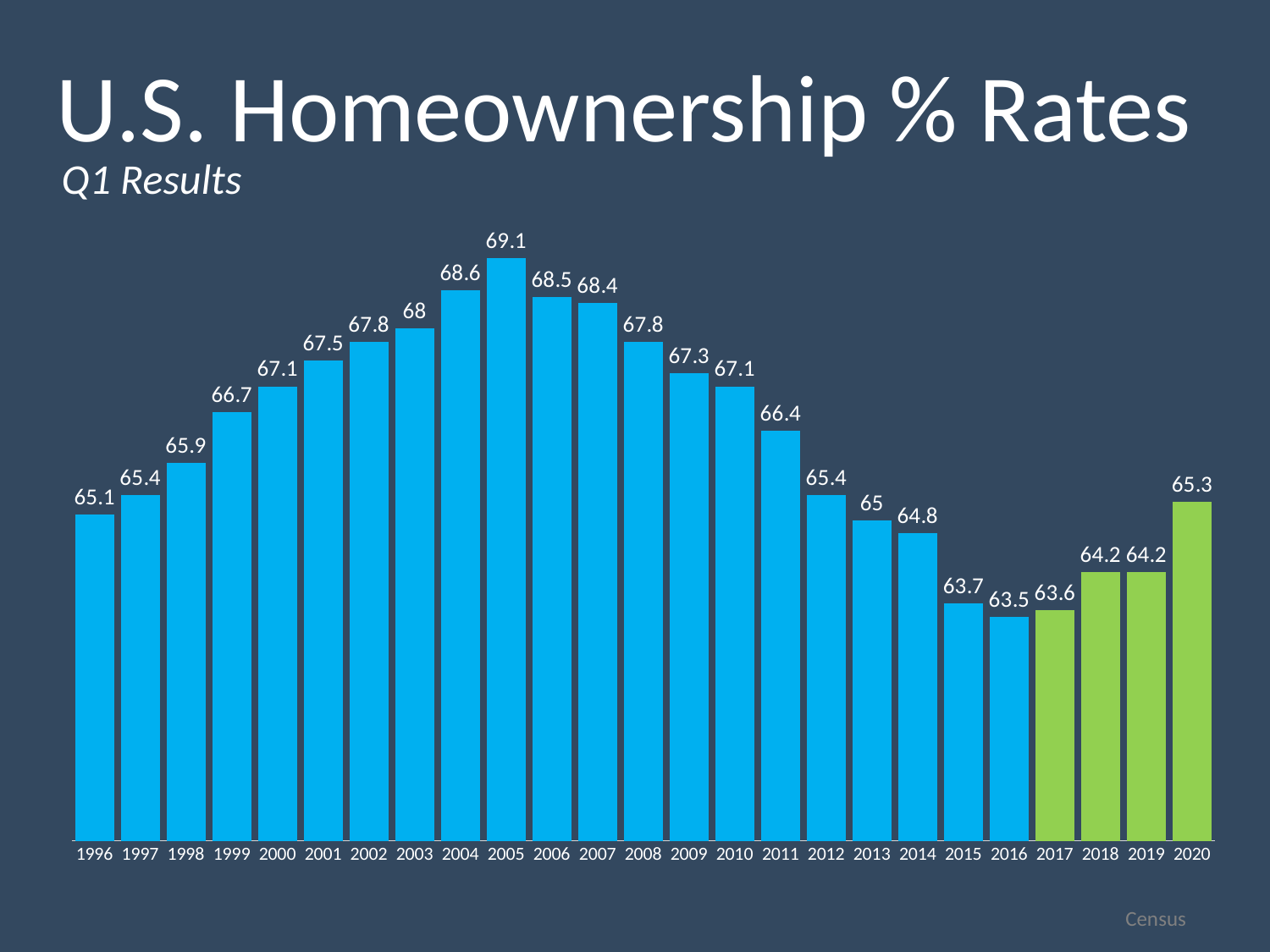
Do the values rise or fall from 2005 to 2016? Fall How many years are shown on the chart? 25 What is the difference between the 2020 rate and the 2019 rate? 1.1 What kind of chart is shown on the slide? Bar chart Which years are shown with green bars instead of blue? 2017, 2018, 2019, 2020 What is the difference between the 2005 rate and the 2016 rate? 5.6 What is the homeownership rate shown for 2020? 65.3 Which year has the highest homeownership rate? 2005 Which year has the lowest homeownership rate? 2016 Which year has a higher homeownership rate, 2011 or 2012? 2011 What is the homeownership rate shown for 2005? 69.1 What is the homeownership rate shown for 1996? 65.1